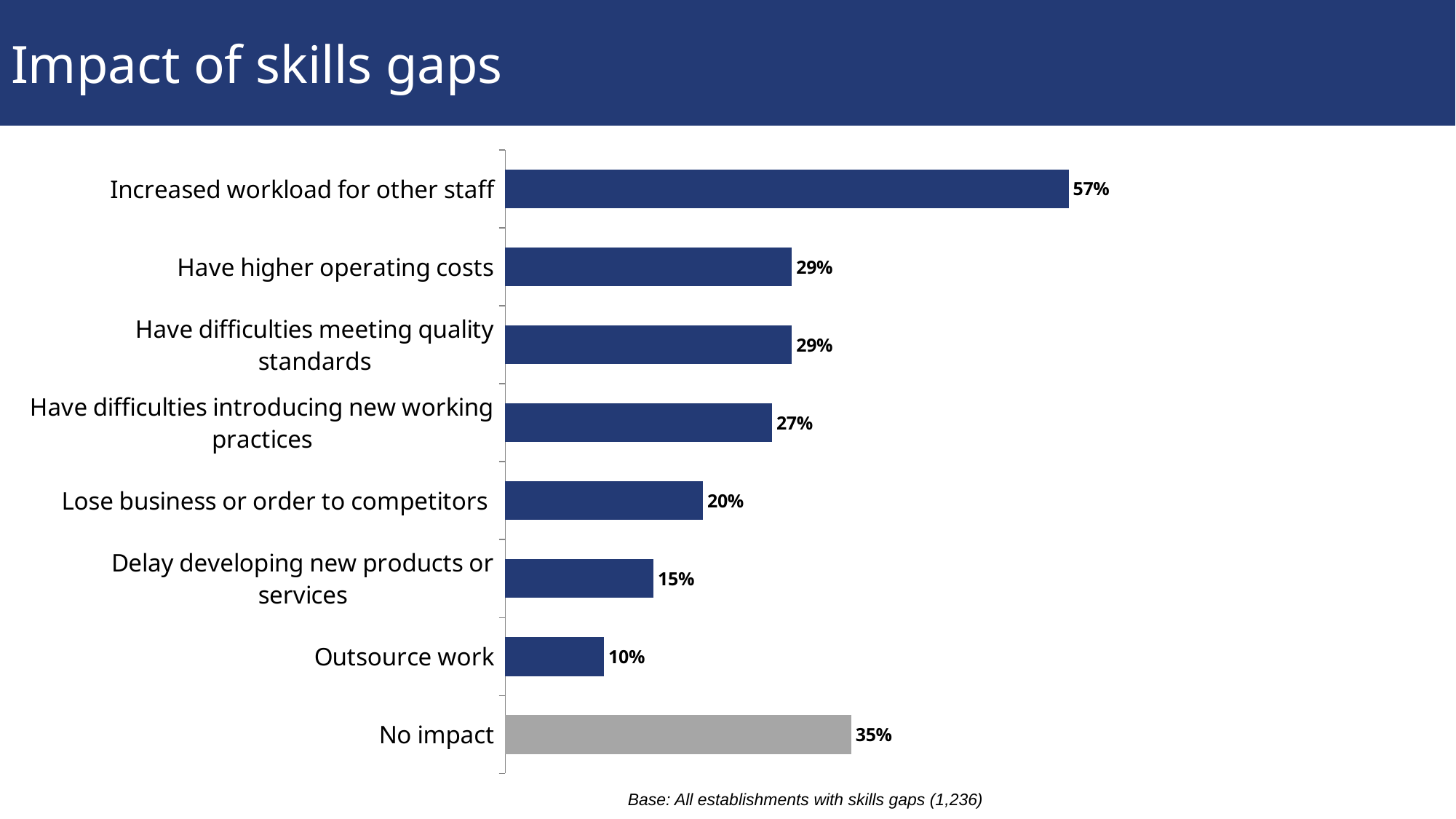
What percentage of establishments reported no impact from skills gaps? 35% Which is larger: the value for 'Delay developing new products or services' or the value for 'Lose business or order to competitors'? Lose business or order to competitors What is the difference between 'No impact' and 'Outsource work'? 25 percentage points Which category has the lowest percentage on the chart? Outsource work What percentage of establishments reported increased workload for other staff as an impact of skills gaps? 57% What type of chart is shown on the slide? Bar chart What is the difference between the percentage for 'Increased workload for other staff' and 'Have higher operating costs'? 28 percentage points How many categories are shown on the chart? 8 What is the value shown for 'Outsource work'? 10% What is the value for 'Lose business or order to competitors'? 20% Which bar is coloured grey rather than dark blue? No impact Which impact has the highest percentage on the chart? Increased workload for other staff